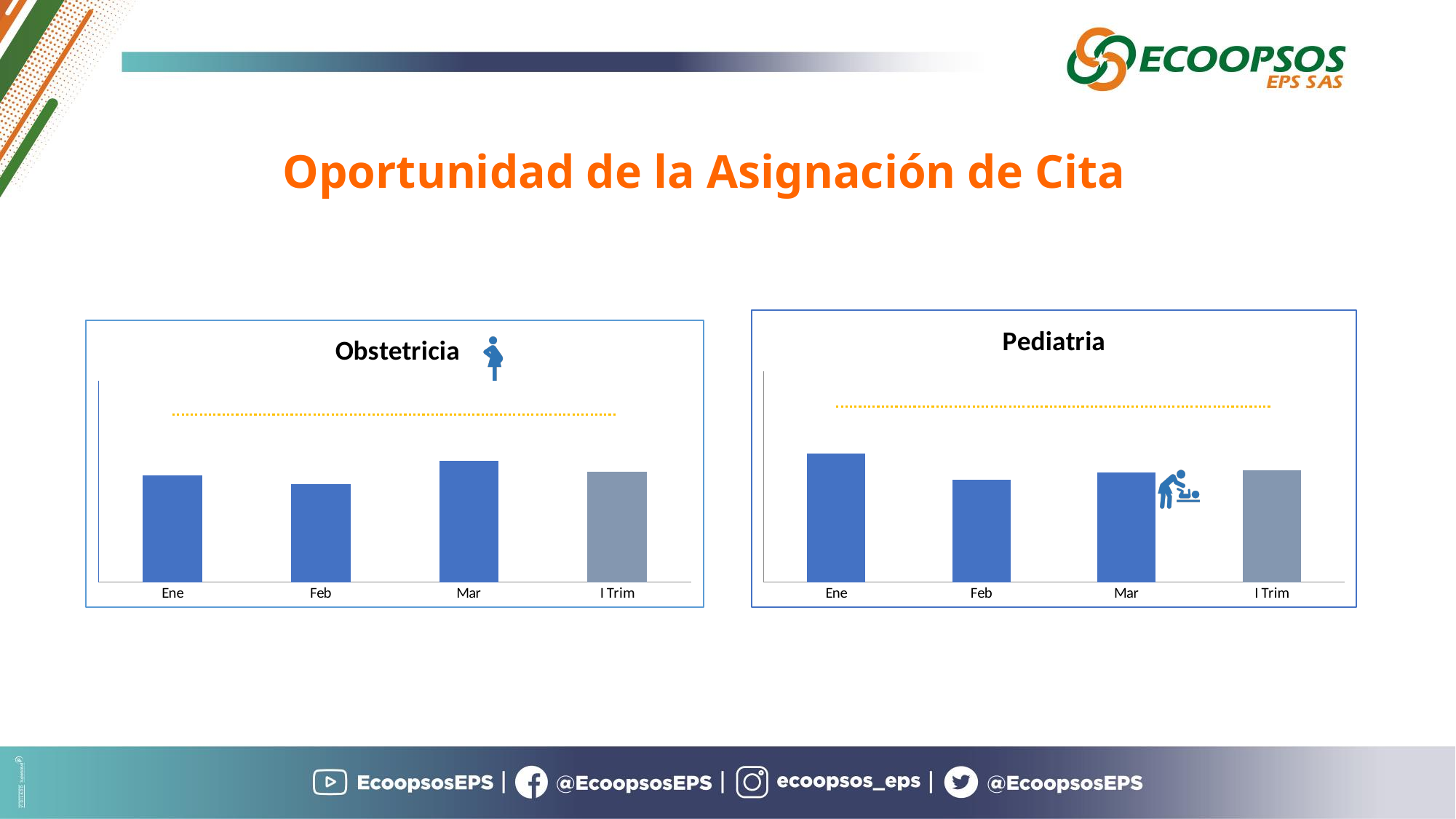
In the Obstetricia chart, which month has the highest bar? Mar In the Pediatria chart, does the value rise or fall from Feb to Mar? rise In the Pediatria chart, which category has the highest bar? Ene How many categories are shown on the x axis of the Pediatria chart? 4 In the Obstetricia chart, which is larger, the bar for Mar or the bar for Feb? Mar In the Pediatria chart, which is larger, the bar for Ene or the bar for Feb? Ene In the Obstetricia chart, does the value rise or fall from Ene to Feb? fall In the Obstetricia chart, which category has the lowest bar? Feb In the Pediatria chart, which category has the lowest bar? Feb What kind of chart is the Obstetricia chart? combination bar and line chart What is the title of the chart on the right side of the slide? Pediatria In the Obstetricia chart, which category's bar is coloured grey rather than blue? I Trim